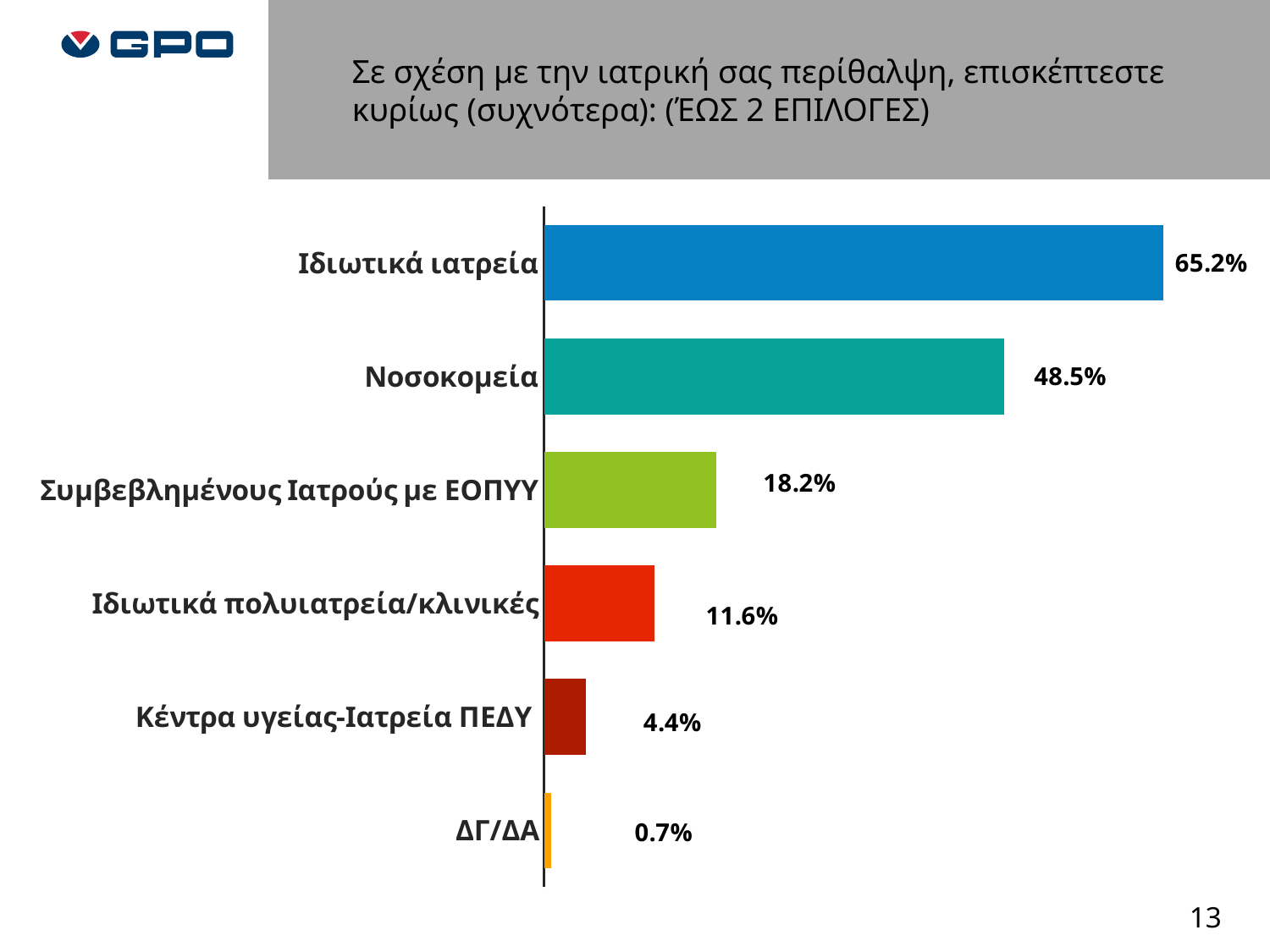
Which is larger, the value for Συμβεβλημένους Ιατρούς με ΕΟΠΥΥ or the value for Ιδιωτικά πολυιατρεία/κλινικές? Συμβεβλημένους Ιατρούς με ΕΟΠΥΥ What kind of chart is shown on the slide? Bar chart What is the difference between the values for Ιδιωτικά ιατρεία and Νοσοκομεία? 16.7% What is the value for Ιδιωτικά ιατρεία? 65.2% What is the difference between the values for Ιδιωτικά πολυιατρεία/κλινικές and Κέντρα υγείας-Ιατρεία ΠΕΔΥ? 7.2% How many categories are shown in the chart? 6 What is the value for Συμβεβλημένους Ιατρούς με ΕΟΠΥΥ? 18.2% What is the value for Κέντρα υγείας-Ιατρεία ΠΕΔΥ? 4.4% Which category has the lowest value? ΔΓ/ΔΑ What colour is the bar for Νοσοκομεία? Teal Which category has the highest value? Ιδιωτικά ιατρεία What is the value for Νοσοκομεία? 48.5%